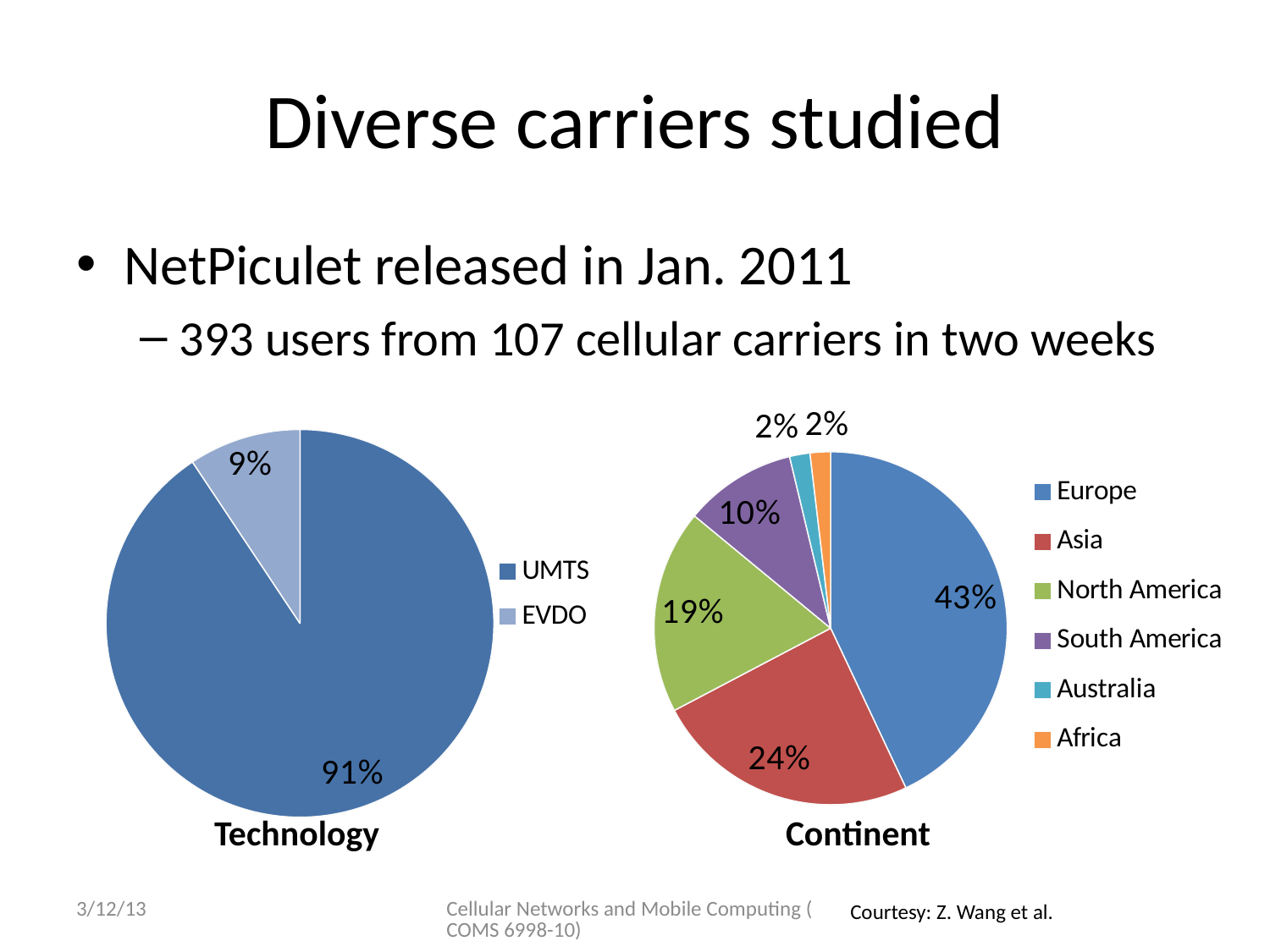
In the Continent chart, what share does Asia have? 24% In the Continent chart, what is the difference between the shares of Europe and Asia? 19% What kind of chart is the Technology chart? pie chart In the Technology chart, what share does EVDO have? 9% In the Continent chart, what share does North America have? 19% In the Continent chart, how many continents are listed in the legend? 6 In the Continent chart, which has the larger share, North America or South America? North America How many series does the legend of the Technology chart list? 2 In the Continent chart, which continent has the largest share? Europe